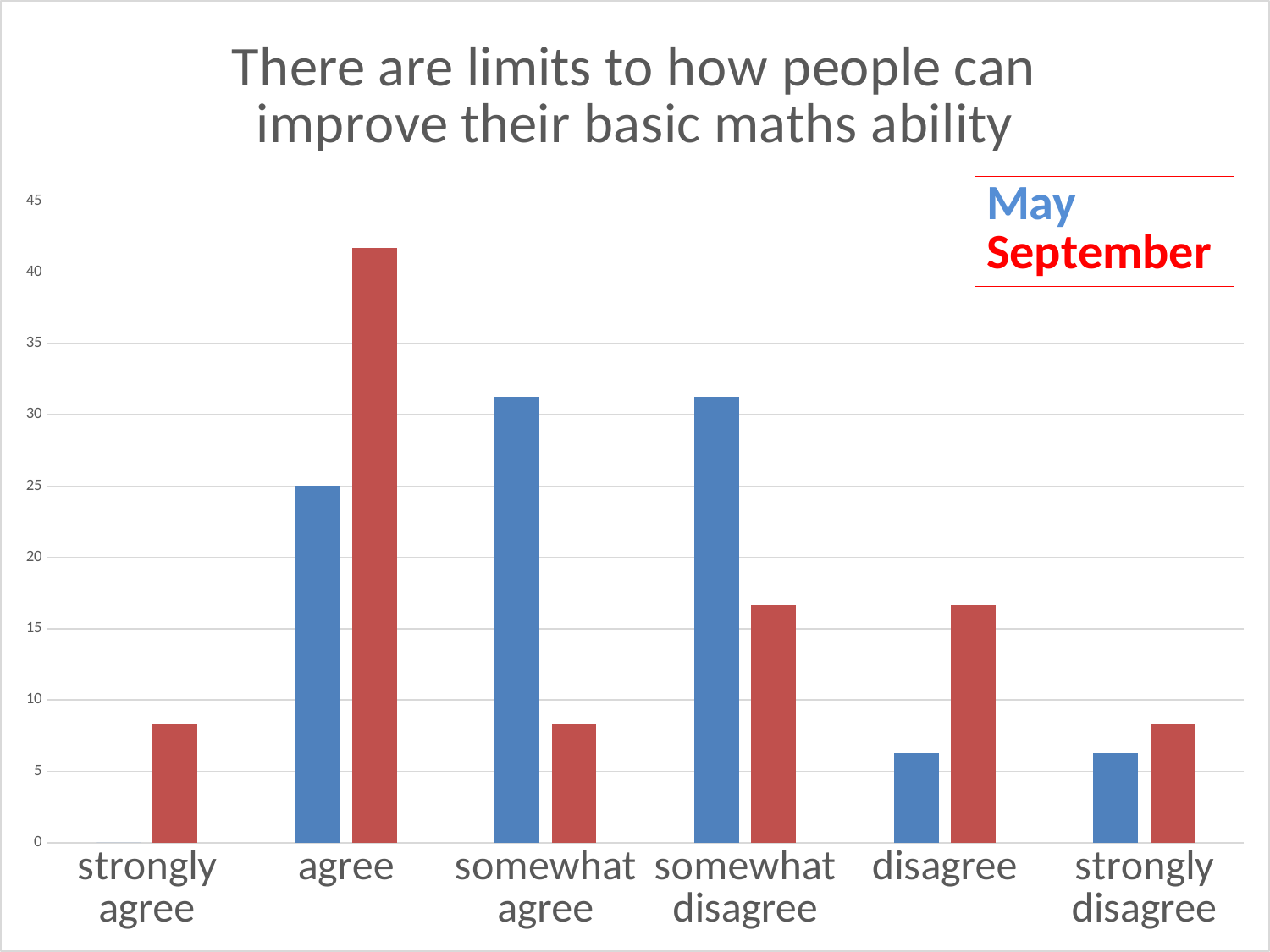
What kind of chart is shown on the slide? bar chart How many response categories are shown on the x axis? 6 Which colour represents the September series? red Which category has the highest May value? somewhat agree and somewhat disagree Is the May value for disagree greater or less than 10? less Is the September value for somewhat agree greater or less than 10? less Is the September value for agree greater or less than 40? greater Which category has the highest September value? agree For the agree category, which series has the larger value, May or September? September How many series does the legend list? 2 For the somewhat disagree category, which series has the larger value, May or September? May